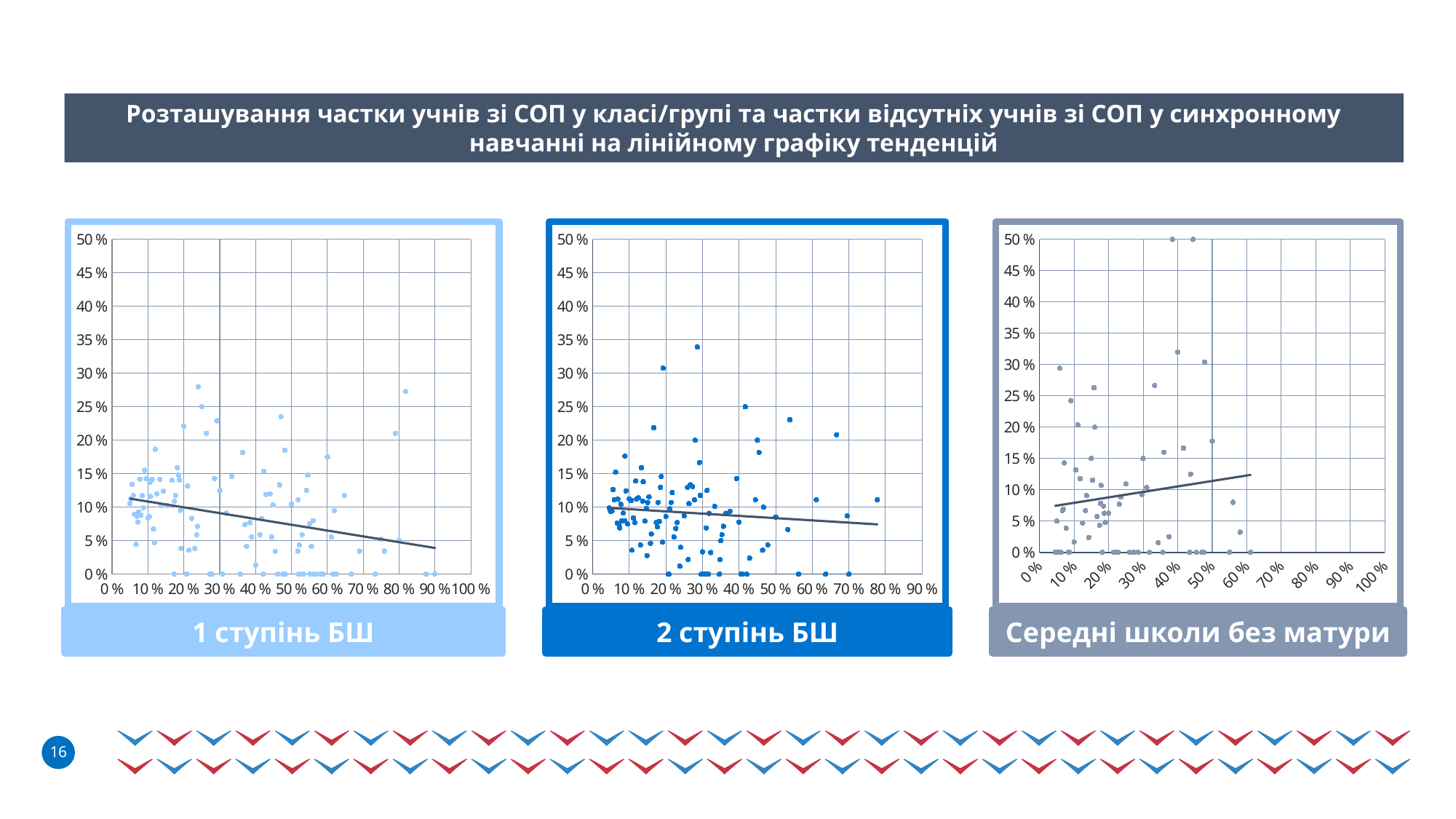
How many charts are shown on the slide? 3 In the '2 ступінь БШ' chart, is the highest plotted point greater or less than 25 %? greater In the 'Середні школи без матури' chart, is the trend line value at 60 % on the x axis greater or less than 10 %? greater What is the label under the middle chart? 2 ступінь БШ What is the highest tick label on the y axis of the '1 ступінь БШ' chart? 50 % In the '1 ступінь БШ' chart, is the highest plotted point greater or less than 20 %? greater In the '2 ступінь БШ' chart, does the trend line rise or fall along the x axis? fall What kind of chart is the '1 ступінь БШ' chart? scatter chart In the '1 ступінь БШ' chart, does the trend line rise or fall as the x-axis value increases? fall In the 'Середні школи без матури' chart, does the trend line rise or fall along the x axis? rise Which of the three charts has a trend line that rises along the x axis? Середні школи без матури